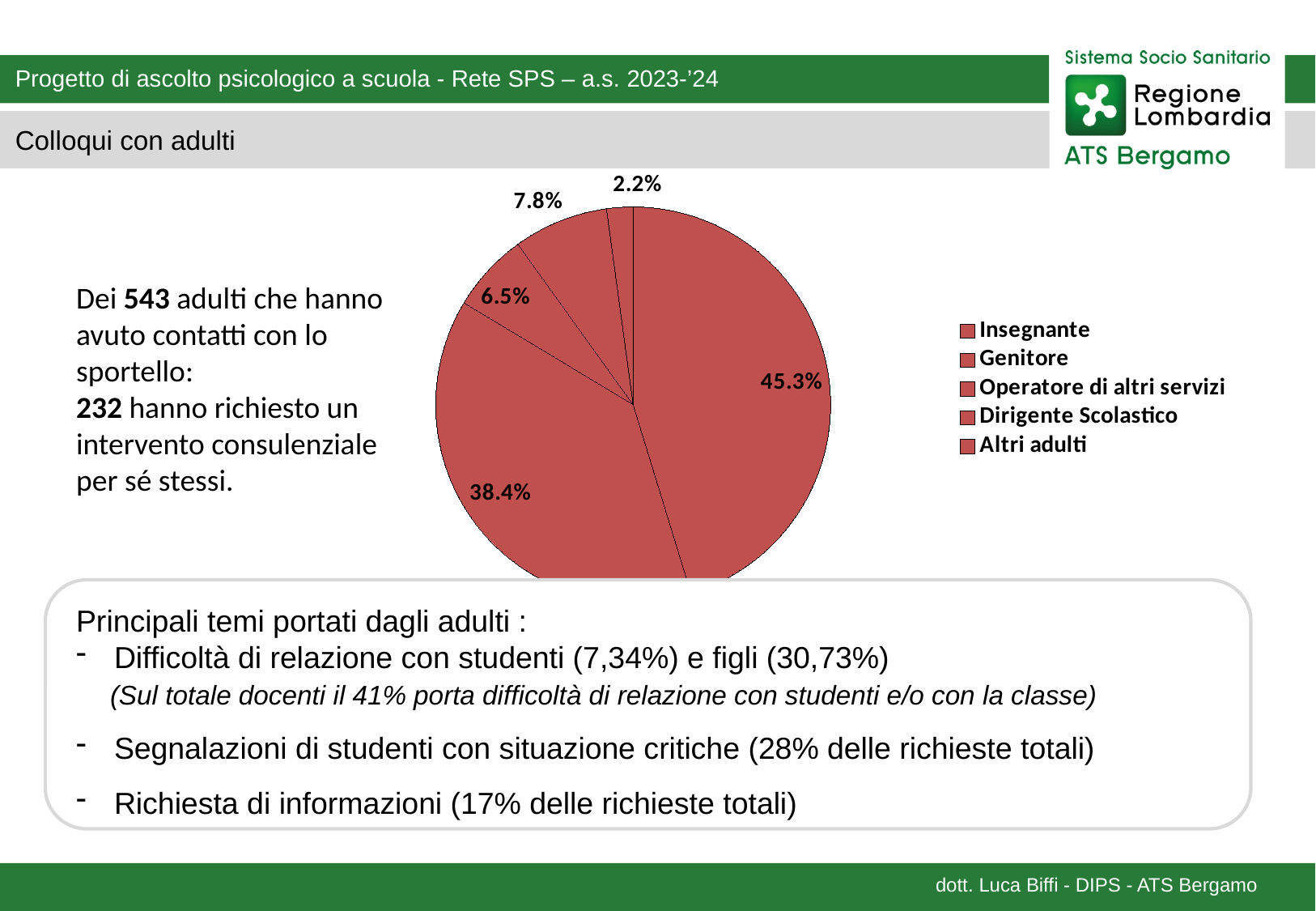
What kind of chart is shown on the slide? pie chart What is the difference between the two largest slices of the pie chart (45.3% and 38.4%)? 6.9% How many slices does the pie chart have? 5 What is the percentage of the smallest slice in the pie chart? 2.2% Which legend entry is listed first in the pie chart's legend? Insegnante Is the largest slice of the pie chart greater or less than 50%? less Which is larger in the pie chart, the 7.8% slice or the 6.5% slice? 7.8% What is the combined share of the two largest slices of the pie chart? 83.7% What is the percentage of the largest slice in the pie chart? 45.3% What is the difference between the 7.8% slice and the 6.5% slice in the pie chart? 1.3% How many entries does the legend of the pie chart list? 5 Which legend entry is listed last in the pie chart's legend? Altri adulti